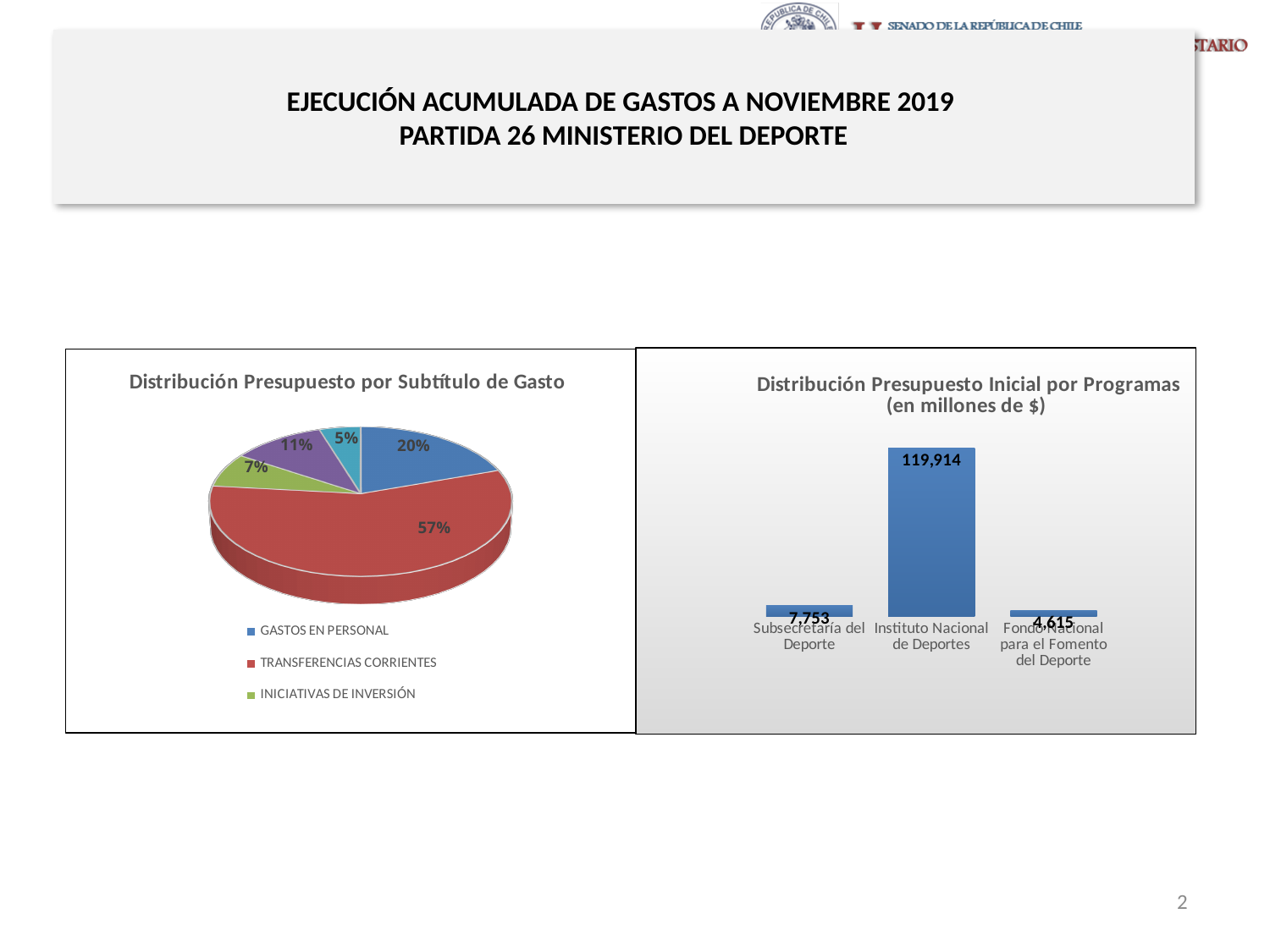
In the pie chart 'Distribución Presupuesto por Subtítulo de Gasto', which is larger: GASTOS EN PERSONAL or INICIATIVAS DE INVERSIÓN? GASTOS EN PERSONAL In the chart 'Distribución Presupuesto Inicial por Programas (en millones de $)', what is the difference between the values for Subsecretaría del Deporte and Fondo Nacional para el Fomento del Deporte? 3,138 In the chart 'Distribución Presupuesto Inicial por Programas (en millones de $)', which program has the lowest value? Fondo Nacional para el Fomento del Deporte What kind of chart is 'Distribución Presupuesto Inicial por Programas (en millones de $)'? Bar chart In the chart 'Distribución Presupuesto Inicial por Programas (en millones de $)', what is the value for Instituto Nacional de Deportes? 119,914 In the pie chart 'Distribución Presupuesto por Subtítulo de Gasto', what share does GASTOS EN PERSONAL have? 20% In the pie chart 'Distribución Presupuesto por Subtítulo de Gasto', what share does TRANSFERENCIAS CORRIENTES have? 57% In the chart 'Distribución Presupuesto Inicial por Programas (en millones de $)', which program has the highest value? Instituto Nacional de Deportes In the chart 'Distribución Presupuesto Inicial por Programas (en millones de $)', what is the value for Subsecretaría del Deporte? 7,753 What kind of chart is 'Distribución Presupuesto por Subtítulo de Gasto'? Pie chart In the chart 'Distribución Presupuesto Inicial por Programas (en millones de $)', how many programs are shown? 3 In the chart 'Distribución Presupuesto Inicial por Programas (en millones de $)', what is the value for Fondo Nacional para el Fomento del Deporte? 4,615